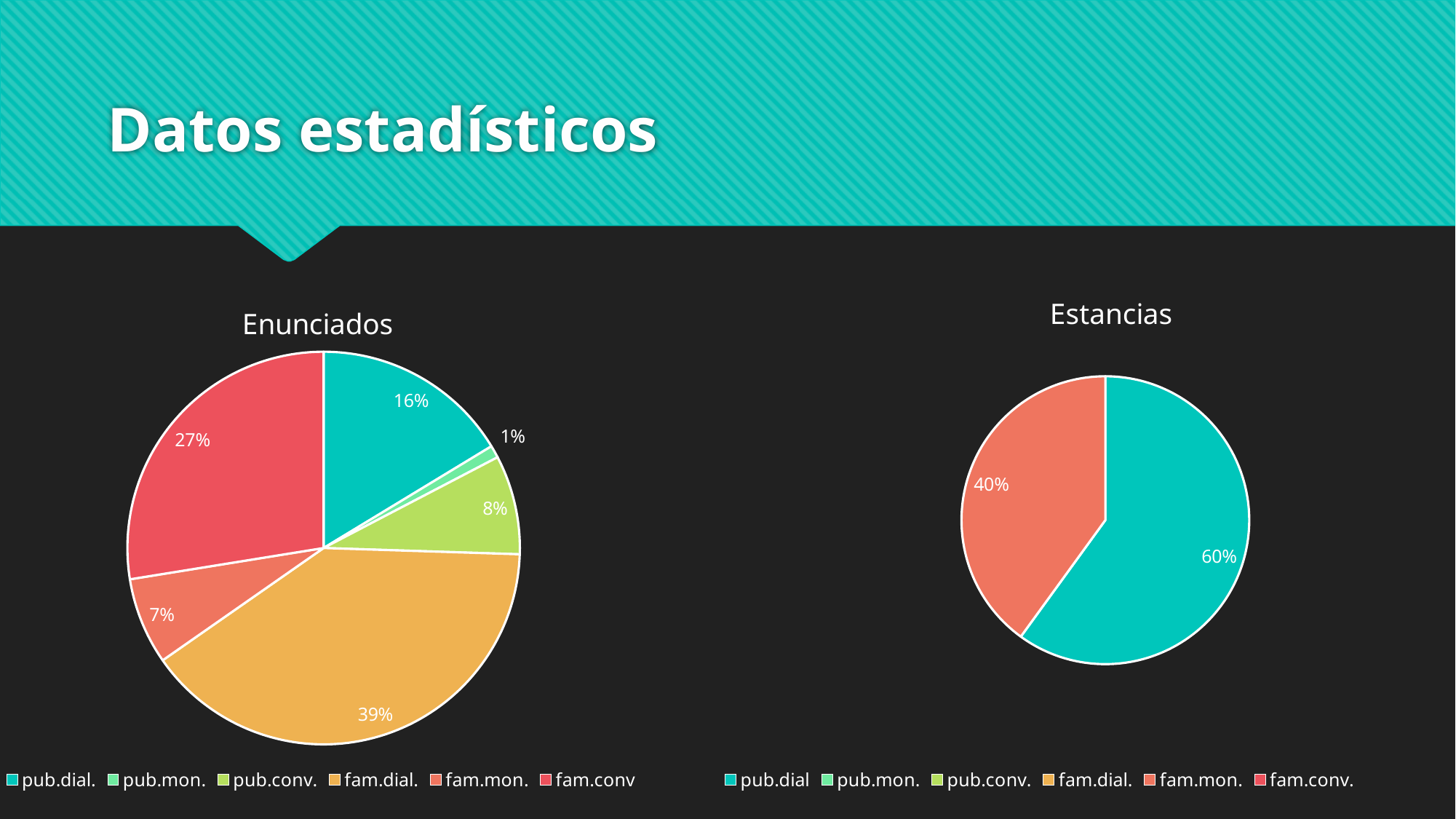
In the Estancias chart, what is the difference between the two slices shown? 20% How many entries does the legend of the Enunciados chart list? 6 In the Enunciados chart, which is larger, pub.conv. or fam.mon.? pub.conv. In the Enunciados chart, what share does pub.dial. have? 16% In the Estancias chart, what share does pub.dial have? 60% In the Enunciados chart, what share does fam.conv have? 27% In the Enunciados chart, which category has the largest slice? fam.dial. In the Enunciados chart, what is the difference between the fam.dial. and fam.conv shares? 12% How many slices are visible in the Estancias chart? 2 In the Enunciados chart, which category has the smallest slice? pub.mon. In the Enunciados chart, what share does fam.dial. have? 39% What type of chart is the Enunciados chart? Pie chart